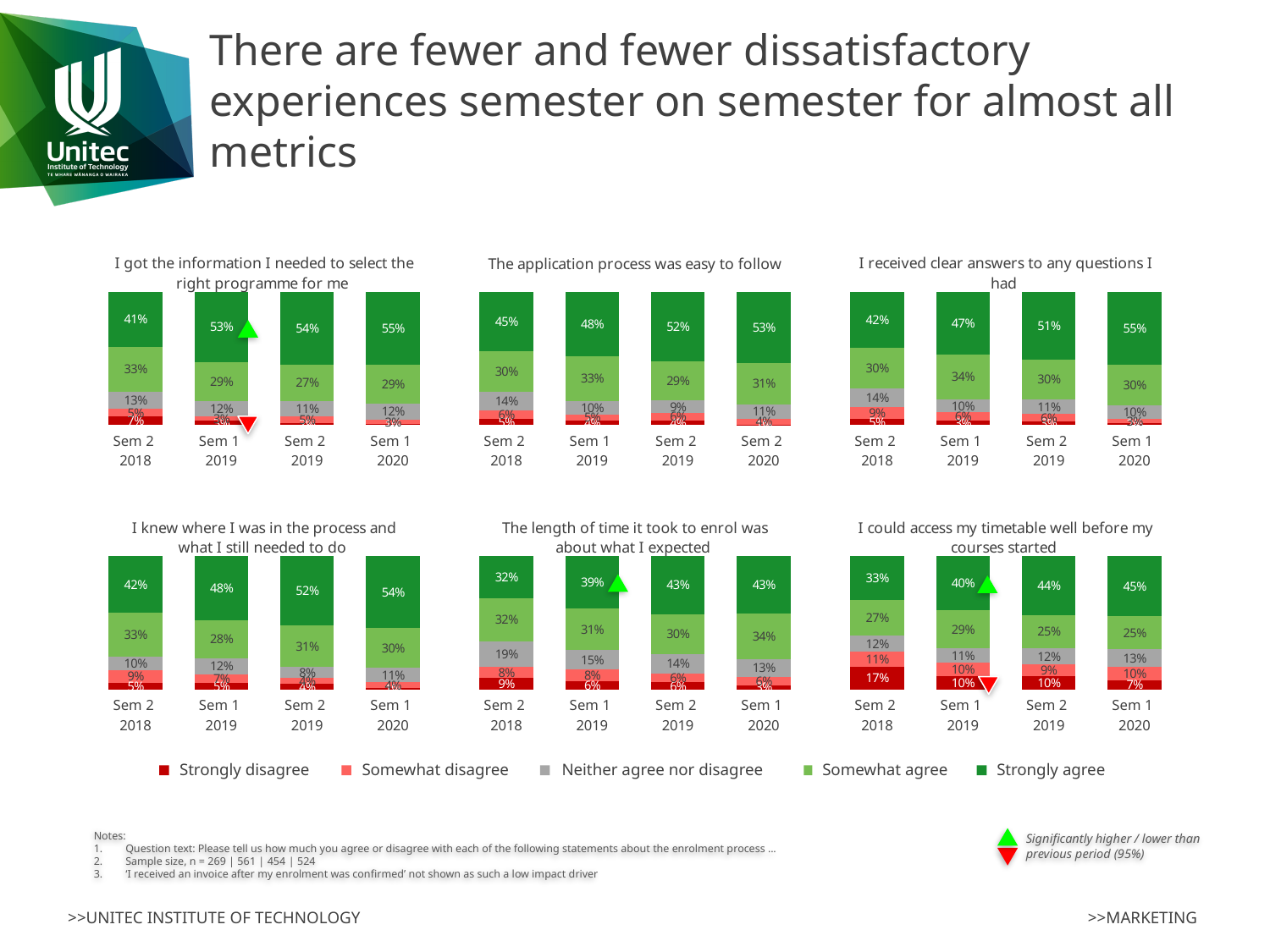
In the chart 'I knew where I was in the process and what I still needed to do', is the Strongly agree value larger for Sem 2 2018 or Sem 1 2020? Sem 1 2020 Which colour represents Strongly disagree in the legend? Dark red How many semesters are shown in the chart 'The application process was easy to follow'? 4 In the chart 'I could access my timetable well before my courses started', what is the Strongly disagree value for Sem 2 2018? 17% In the chart 'I got the information I needed to select the right programme for me', what is the Strongly agree value for Sem 1 2020? 55% In the chart 'I could access my timetable well before my courses started', what is the difference between the Strongly agree values for Sem 1 2020 and Sem 2 2018? 12% How many series does the legend list? 5 In the chart 'I received clear answers to any questions I had', which semester has the highest Strongly agree value? Sem 1 2020 In the chart 'I knew where I was in the process and what I still needed to do', does the Strongly agree value rise or fall from Sem 2 2018 to Sem 1 2020? Rise In the chart 'The application process was easy to follow', what is the Somewhat agree value for Sem 1 2019? 33% What kind of chart is 'I received clear answers to any questions I had'? Stacked bar chart In the chart 'The length of time it took to enrol was about what I expected', which semester has the lowest Neither agree nor disagree value? Sem 1 2020